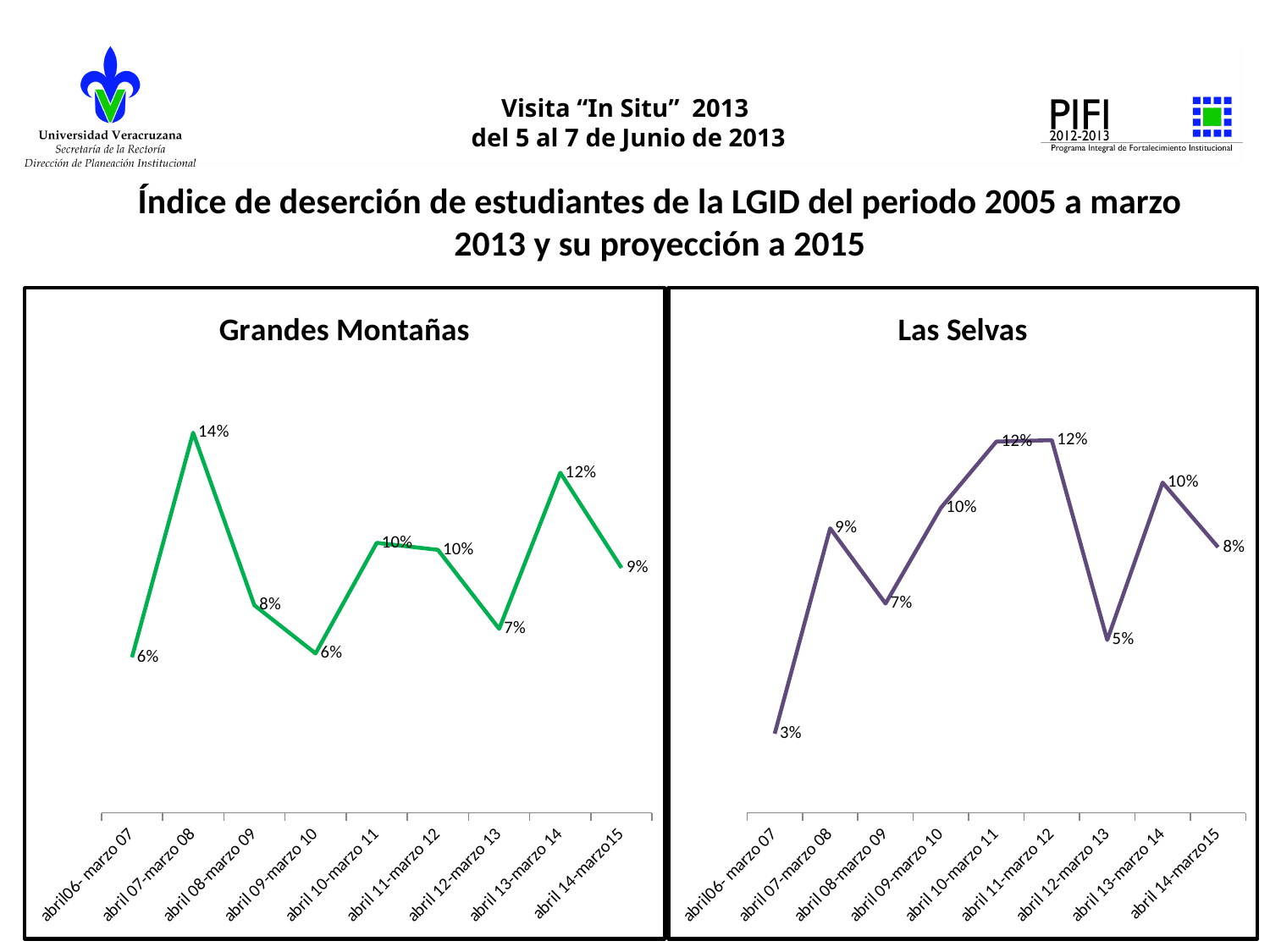
In the Grandes Montañas chart, which period has the highest value? abril 07-marzo 08 In the Grandes Montañas chart, what is the difference between the values for abril 07-marzo 08 and abril 08-marzo 09? 6% In the Las Selvas chart, what is the difference between the values for abril 11-marzo 12 and abril 12-marzo 13? 7% In the Las Selvas chart, does the value rise or fall from abril 13-marzo 14 to abril 14-marzo15? fall In the Las Selvas chart, what is the value for abril06- marzo 07? 3% In the Grandes Montañas chart, which is larger, the value for abril 13-marzo 14 or the value for abril 14-marzo15? abril 13-marzo 14 In the Las Selvas chart, which is larger, the value for abril 07-marzo 08 or the value for abril 08-marzo 09? abril 07-marzo 08 How many periods are plotted in the Las Selvas chart? 9 In the Las Selvas chart, what is the value for abril 12-marzo 13? 5% In the Las Selvas chart, which period has the lowest value? abril06- marzo 07 What kind of chart is the Grandes Montañas chart? line chart In the Grandes Montañas chart, what is the value for abril 07-marzo 08? 14%